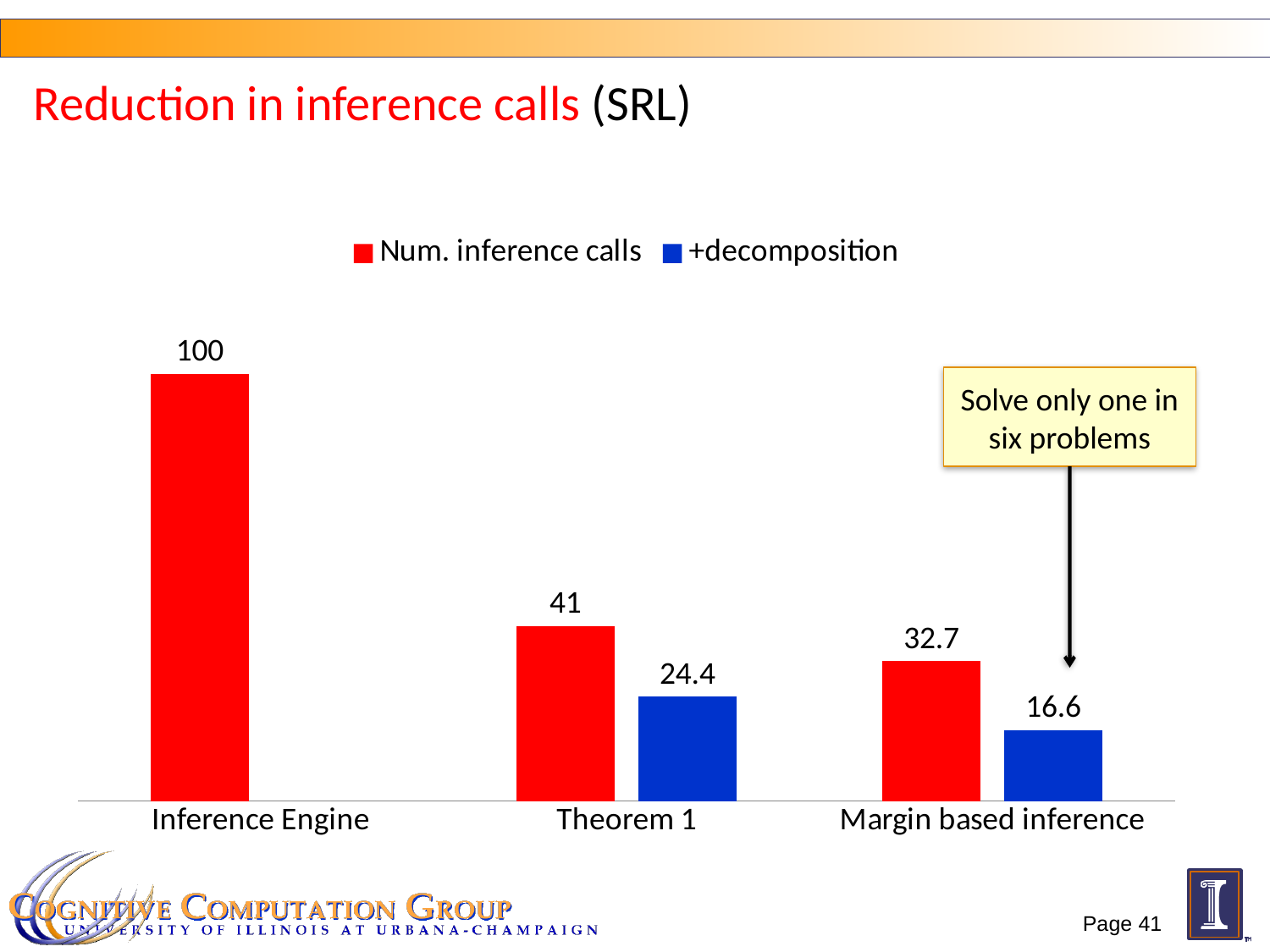
Which is larger: Num. inference calls for Theorem 1 or Num. inference calls for Margin based inference? Theorem 1 What is the value of Num. inference calls for Margin based inference? 32.7 How many categories are shown on the x axis? 3 What is the value of +decomposition for Theorem 1? 24.4 What kind of chart is shown on the slide? Bar chart Which category has the highest value for Num. inference calls? Inference Engine What colour are the bars for the +decomposition series? Blue How many series does the legend list? 2 Which category has the lowest value for +decomposition? Margin based inference What is the difference between Num. inference calls and +decomposition for Theorem 1? 16.6 What is the value of +decomposition for Margin based inference? 16.6 What is the value of Num. inference calls for Inference Engine? 100